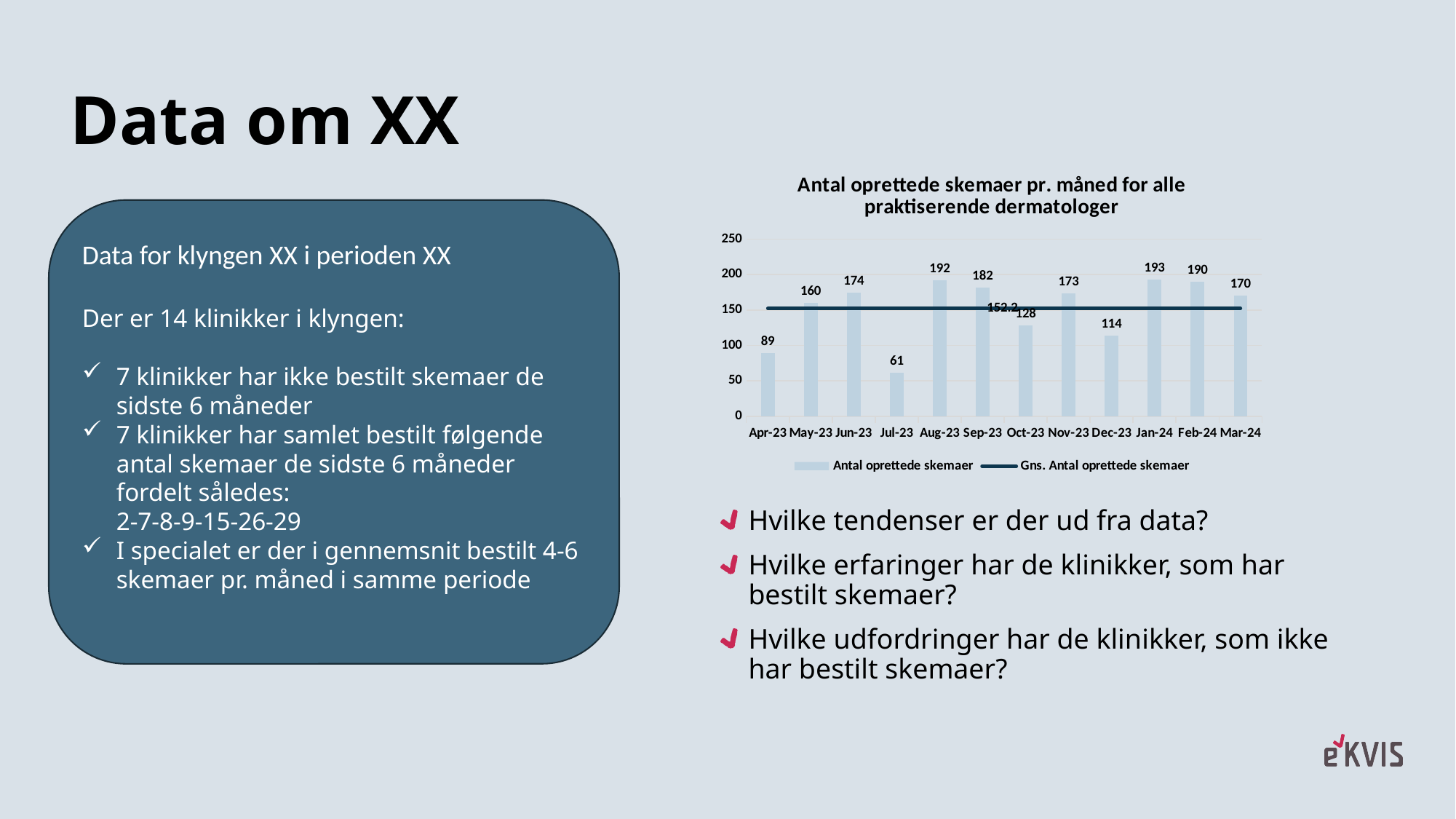
Is the value for Apr-23 greater or less than 100? less What is the value for Jul-23 in the chart? 61 What is the value for Aug-23 in the chart? 192 Which is larger, the value for Oct-23 or the value for Nov-23? Nov-23 Which month has the highest number of created forms (Antal oprettede skemaer)? Jan-24 What is the difference between the values for Feb-24 and Mar-24? 20 What type of chart is shown on the slide? Combination bar and line chart How many months are shown on the x axis of the chart? 12 What is the value for Dec-23 in the chart? 114 How many series does the chart legend list? 2 What is the title of the chart? Antal oprettede skemaer pr. måned for alle praktiserende dermatologer Which month has the lowest number of created forms (Antal oprettede skemaer)? Jul-23